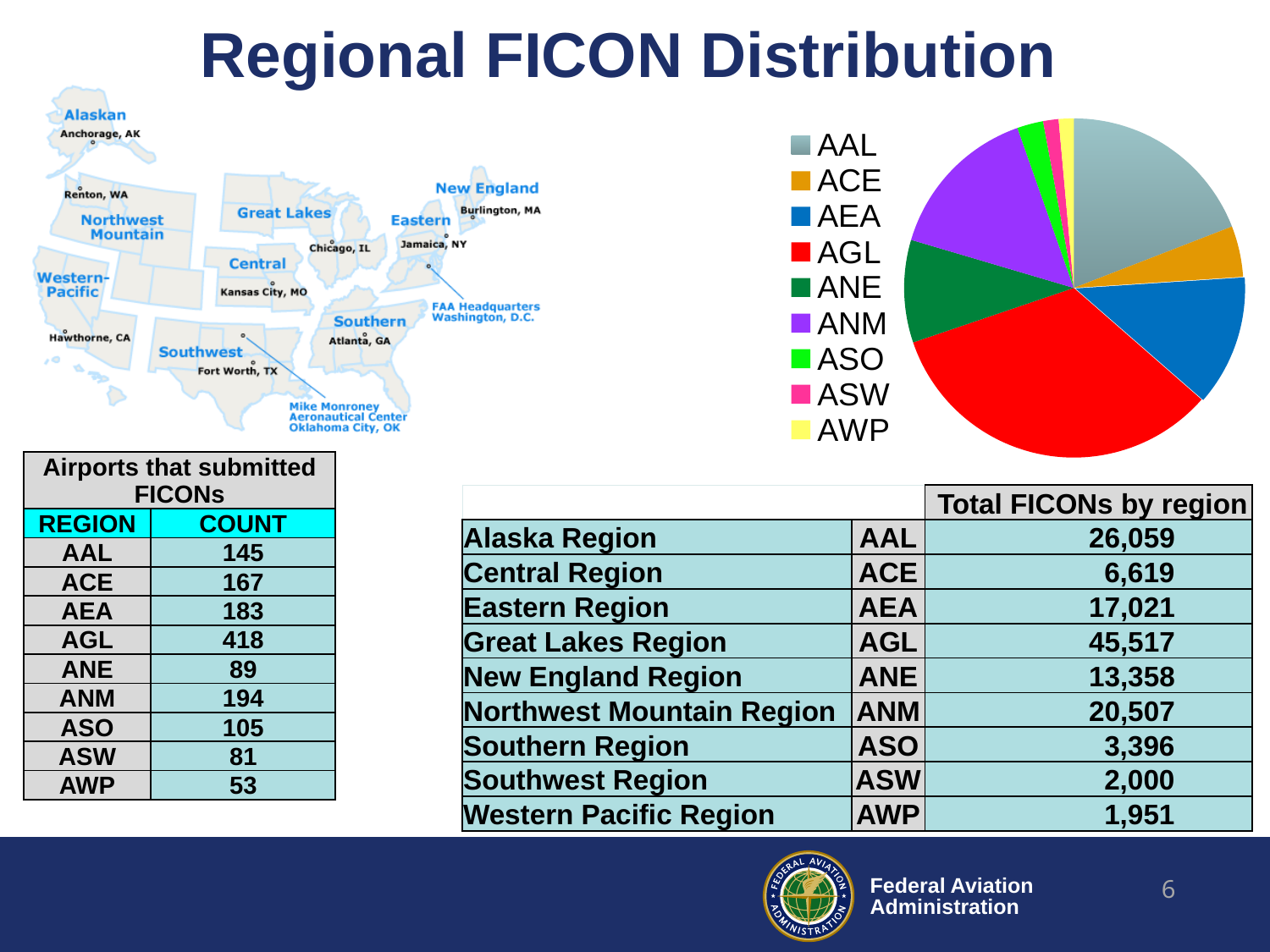
What is the total FICONs value for the Great Lakes Region (AGL) shown on the slide? 45,517 What colour is the AGL slice in the pie chart? red How many slices does the pie chart have? 9 Which region has the largest slice in the pie chart? AGL Which slice is larger in the pie chart, ANM or ANE? ANM Which slice is larger in the pie chart, AEA or ACE? AEA What is the total FICONs value for the Alaska Region (AAL) shown on the slide? 26,059 What kind of chart is shown on the slide? pie chart Which slice is larger in the pie chart, ASO or AGL? AGL Which legend entry is shown in yellow in the pie chart? AWP How many entries does the pie chart's legend list? 9